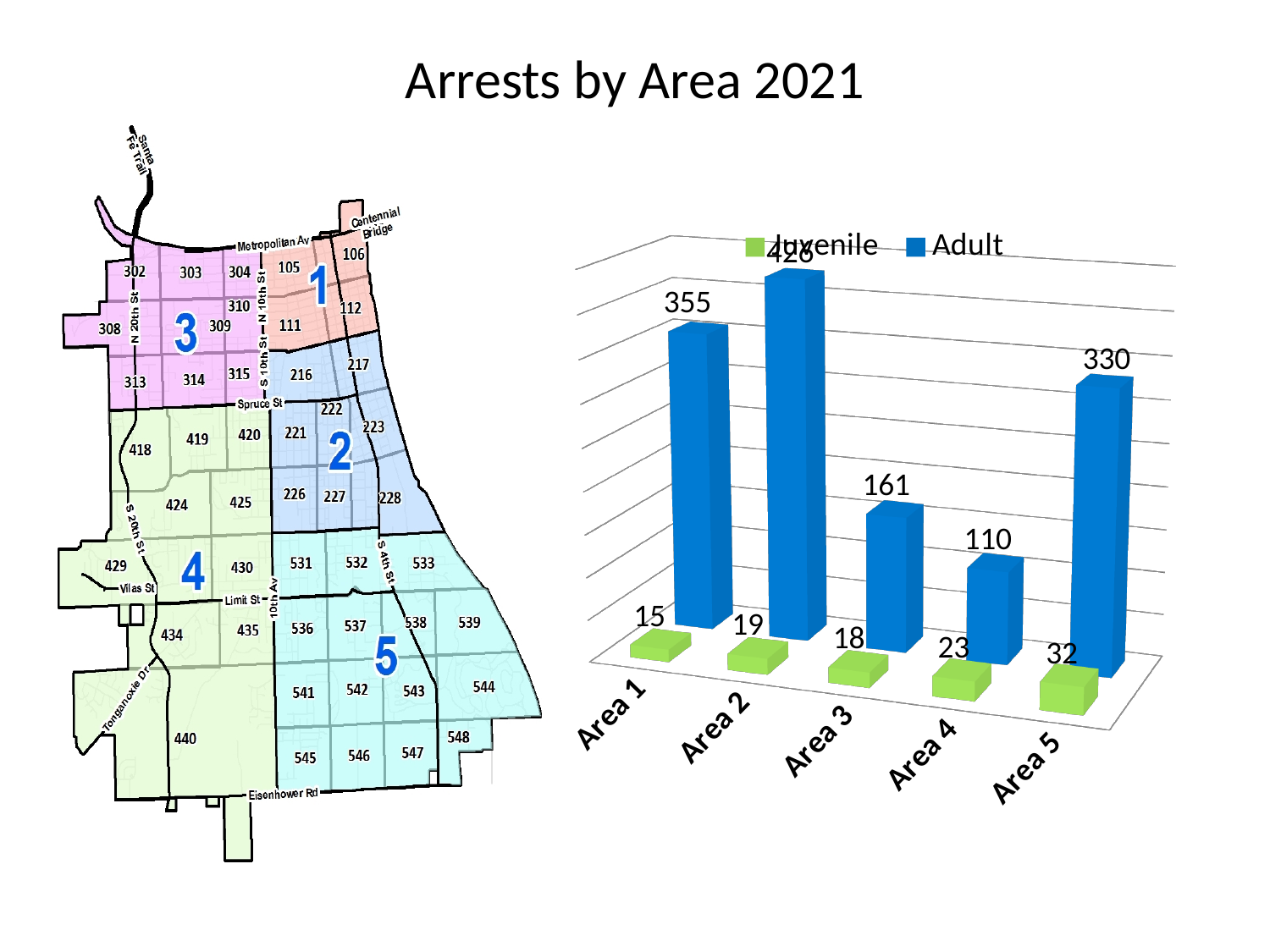
Which area has the highest Juvenile value? Area 5 What is the Juvenile value for Area 5? 32 What is the difference between the Adult values for Area 1 and Area 5? 25 Which area has the lowest Adult value? Area 4 Which has the larger Adult value, Area 3 or Area 4? Area 3 Which area has the lowest Juvenile value? Area 1 What kind of chart is shown on the slide? Bar chart How many series does the chart legend list? 2 What is the Adult value for Area 1? 355 Which area has the highest Adult value? Area 2 What is the Adult value for Area 4? 110 How many areas are shown on the x axis of the chart? 5